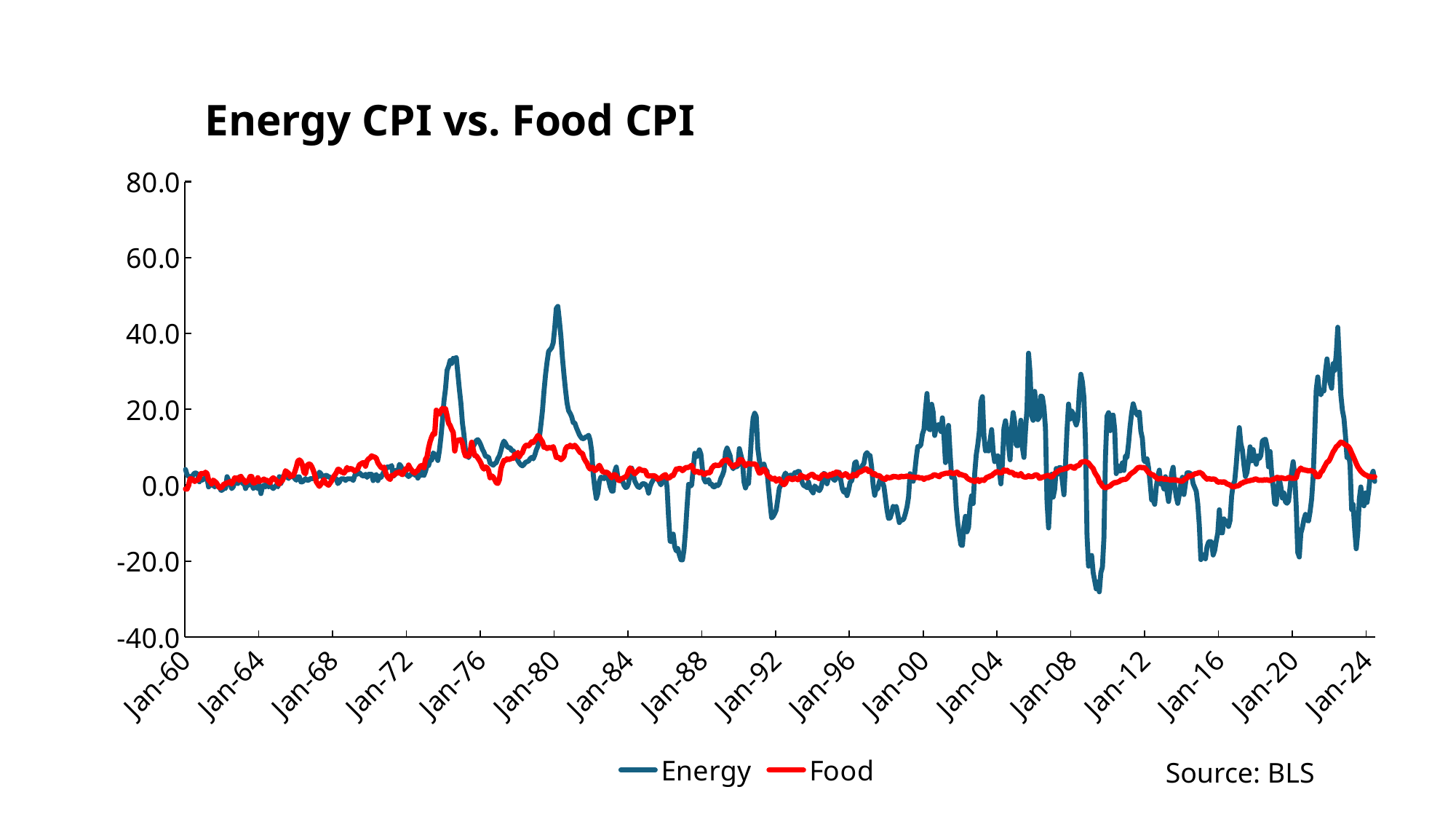
Which series reaches the lowest value anywhere on the chart, Energy or Food? Energy What is the title of the chart? Energy CPI vs. Food CPI What is the highest value shown on the y axis? 80.0 Which series is drawn in red? Food Is the peak value of the Food series around Jan-20 to Jan-24 greater or less than 20? less How many series does the legend list? 2 How many labelled tick marks are on the x axis? 17 Which series reaches the highest value anywhere on the chart, Energy or Food? Energy What kind of chart is shown on the slide? line chart Is the lowest value of the Energy series around Jan-08 to Jan-12 greater or less than -20? less Around Jan-80, which series has the larger value, Energy or Food? Energy Is the peak value of the Energy series around Jan-80 greater or less than 40? greater